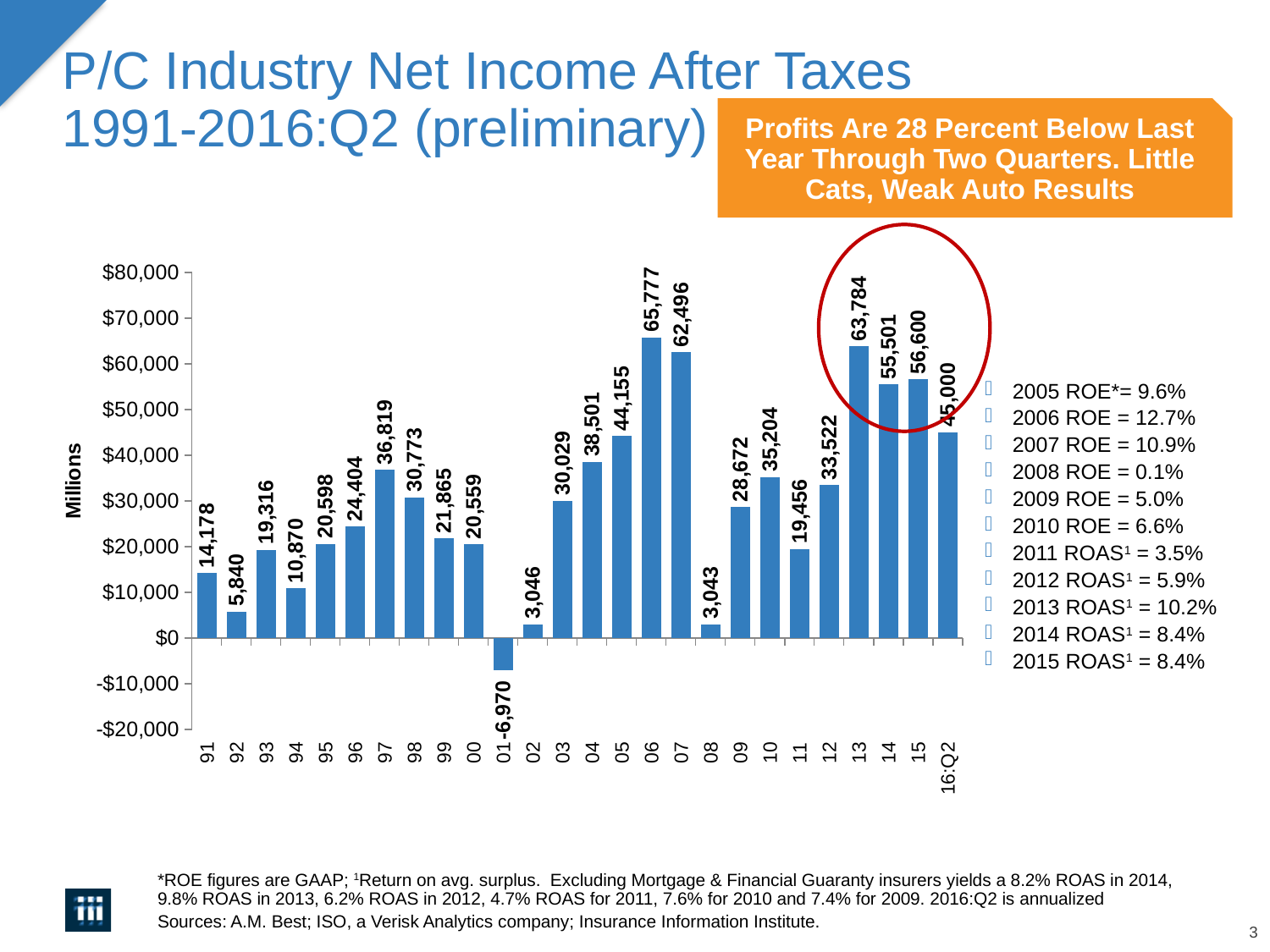
What is the label on the vertical axis of the chart? Millions What is the difference between the 2013 value (63,784) and the 2014 value (55,501)? 8,283 Which year has the highest net income after taxes in the chart? 06 Is the value for 16:Q2 greater or less than $40,000? greater What kind of chart is shown on the slide? Bar chart What is the difference between the 2015 value and the 2014 value? 1,099 How many bars (periods) are plotted in the chart? 26 What was P/C industry net income after taxes in 2006 (bar labeled 06)? 65,777 What value is shown for 2001 (bar labeled 01)? -6,970 Which year has the lowest net income after taxes in the chart? 01 Which is larger, the value for 2007 or the value for 2013? 2013 What value is shown for 2008 (bar labeled 08)? 3,043